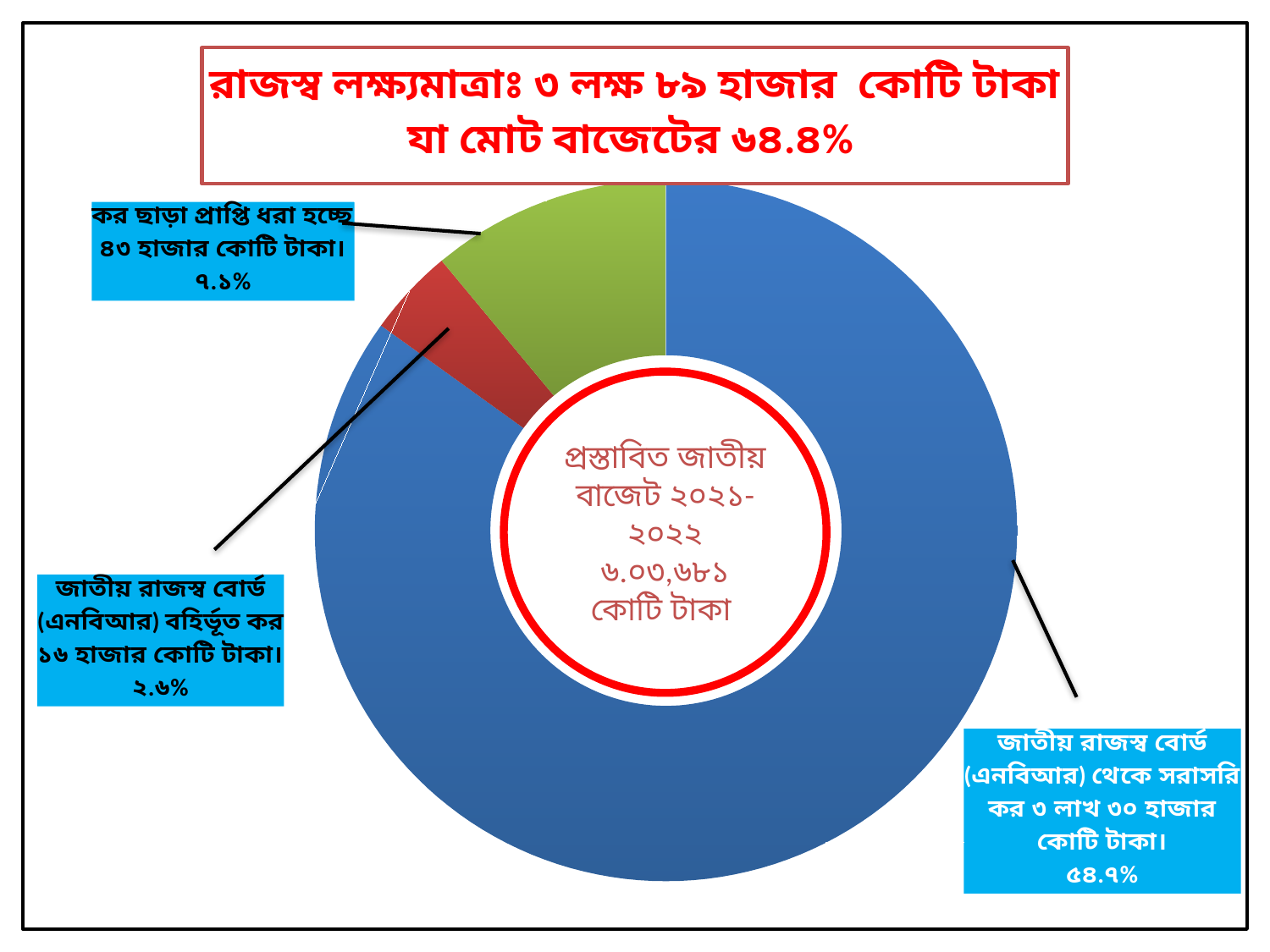
What colour is the largest slice of the pie chart? blue What total budget amount is written in the centre of the pie chart? ৬.০৩,৬৮১ কোটি টাকা Which slice of the pie chart is the largest? জাতীয় রাজস্ব বোর্ড (এনবিআর) থেকে সরাসরি কর (direct tax from NBR) What percentage is shown for the slice labelled জাতীয় রাজস্ব বোর্ড (এনবিআর) বহির্ভূত কর (non-NBR tax)? ২.৬% What percentage is shown for the slice labelled কর ছাড়া প্রাপ্তি (non-tax receipts)? ৭.১% Which slice of the pie chart is the smallest? জাতীয় রাজস্ব বোর্ড (এনবিআর) বহির্ভূত কর (non-NBR tax) What kind of chart is shown on the slide? doughnut chart What amount in কোটি টাকা is labelled for the NBR direct tax slice? ৩ লাখ ৩০ হাজার কোটি টাকা How many slices does the pie chart have? 3 What is the difference in percentage points between the NBR direct tax slice (৫৪.৭%) and the non-tax receipts slice (৭.১%)? ৪৭.৬% What percentage is shown for the slice labelled জাতীয় রাজস্ব বোর্ড (এনবিআর) থেকে সরাসরি কর (direct tax from NBR)? ৫৪.৭% Which is larger: the green slice (কর ছাড়া প্রাপ্তি) or the red slice (এনবিআর বহির্ভূত কর)? the green slice (কর ছাড়া প্রাপ্তি)